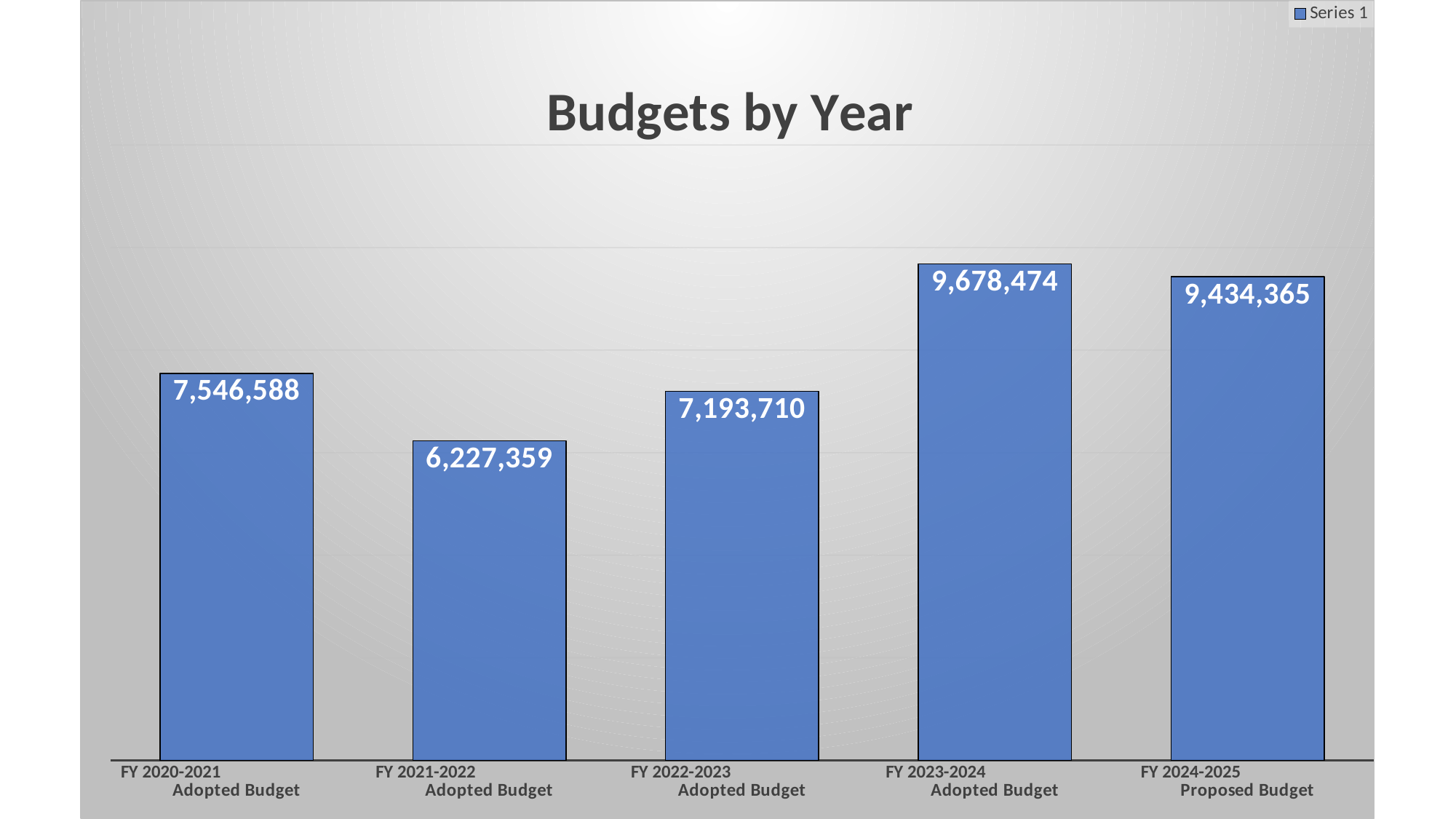
What is the title of the chart? Budgets by Year Which fiscal year has the lowest budget? FY 2021-2022 Adopted Budget What is the value for FY 2020-2021 Adopted Budget? 7,546,588 Which fiscal year has the highest budget? FY 2023-2024 Adopted Budget What is the difference between the FY 2020-2021 Adopted Budget and the FY 2021-2022 Adopted Budget? 1,319,229 How many series does the legend list? 1 What is the value for FY 2021-2022 Adopted Budget? 6,227,359 What is the value for FY 2024-2025 Proposed Budget? 9,434,365 How many fiscal years are shown in the chart? 5 What kind of chart is shown on the slide? Bar chart Which is larger, the FY 2020-2021 Adopted Budget or the FY 2022-2023 Adopted Budget? FY 2020-2021 Adopted Budget What is the difference between the FY 2023-2024 Adopted Budget and the FY 2024-2025 Proposed Budget? 244,109